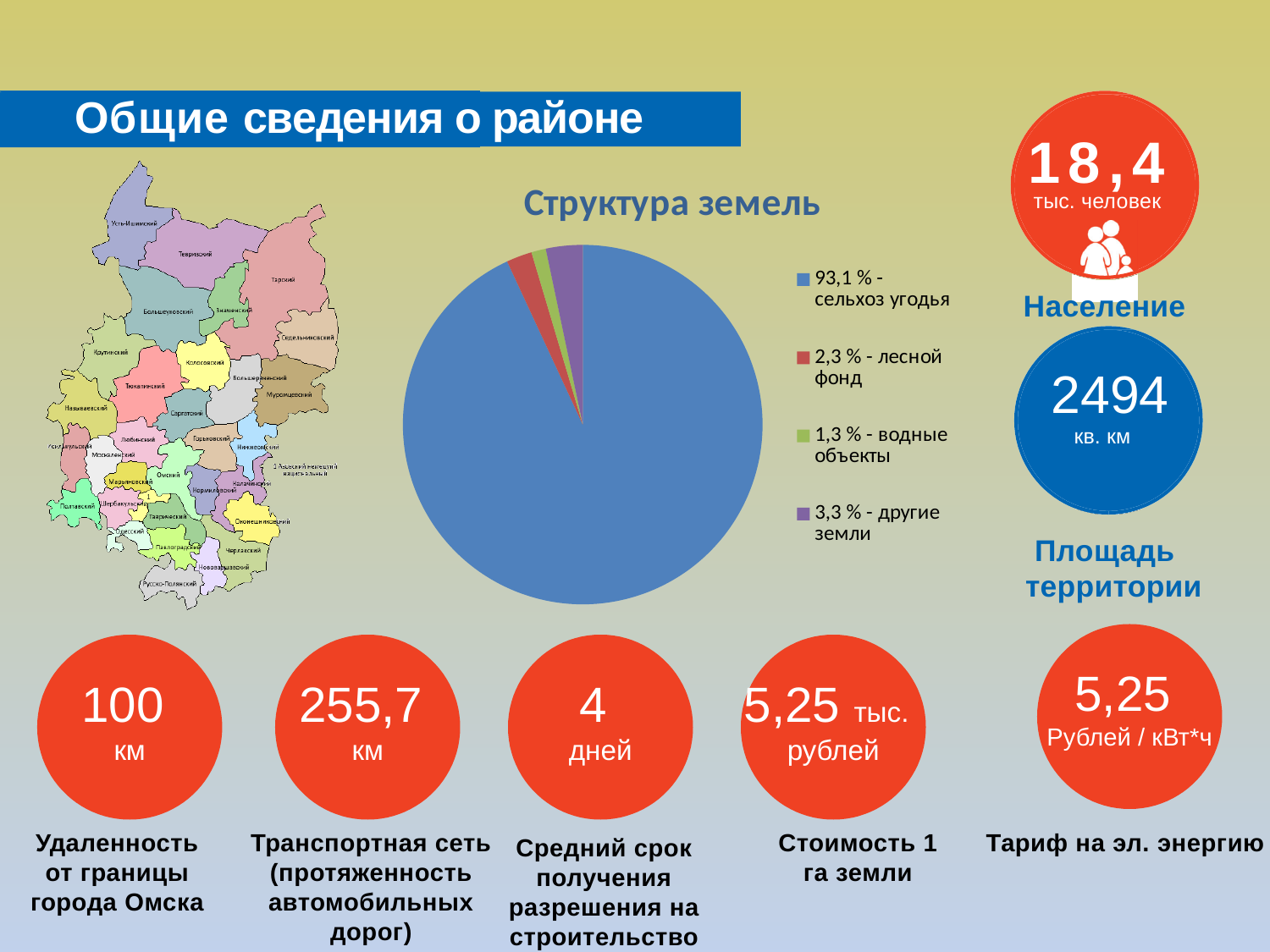
In the pie chart "Структура земель", what share is labelled for сельхоз угодья? 93,1 % In the pie chart "Структура земель", what is the difference between the shares of другие земли and лесной фонд? 1,0 % How many slices does the pie chart "Структура земель" have? 4 Which category has the largest slice in the pie chart "Структура земель"? сельхоз угодья In the pie chart "Структура земель", what share is labelled for лесной фонд? 2,3 % What type of chart is shown under the title "Структура земель"? pie chart In the pie chart "Структура земель", what colour is the slice for сельхоз угодья? blue What is the title of the pie chart on the slide? Структура земель In the pie chart "Структура земель", which is larger: лесной фонд or другие земли? другие земли Which category has the smallest slice in the pie chart "Структура земель"? водные объекты In the pie chart "Структура земель", what share is labelled for другие земли? 3,3 % In the pie chart "Структура земель", what share is labelled for водные объекты? 1,3 %